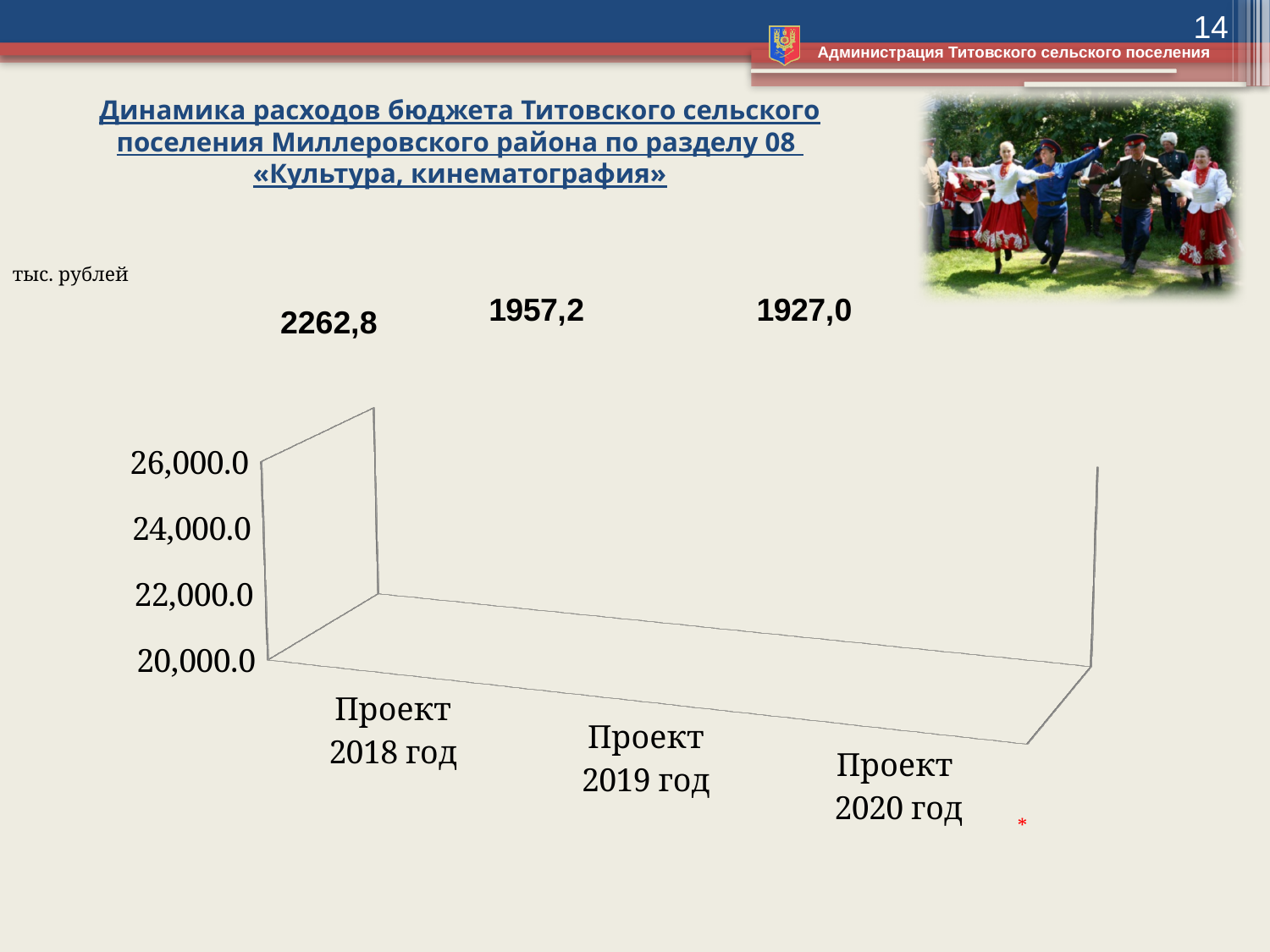
What is the difference between the values for Проект 2018 год and Проект 2019 год? 305,6 In what units are the values on the chart expressed? тыс. рублей Do the values rise or fall from Проект 2018 год to Проект 2020 год? fall Which year has the highest value? Проект 2018 год What is the difference between the values for Проект 2018 год and Проект 2020 год? 335,8 What is the value for Проект 2019 год? 1957,2 Which is larger, the value for Проект 2018 год or Проект 2020 год? Проект 2018 год Which year has the lowest value? Проект 2020 год What is the value for Проект 2020 год? 1927,0 What is the value for Проект 2018 год? 2262,8 How many categories are shown on the x axis? 3 What is the difference between the values for Проект 2019 год and Проект 2020 год? 30,2